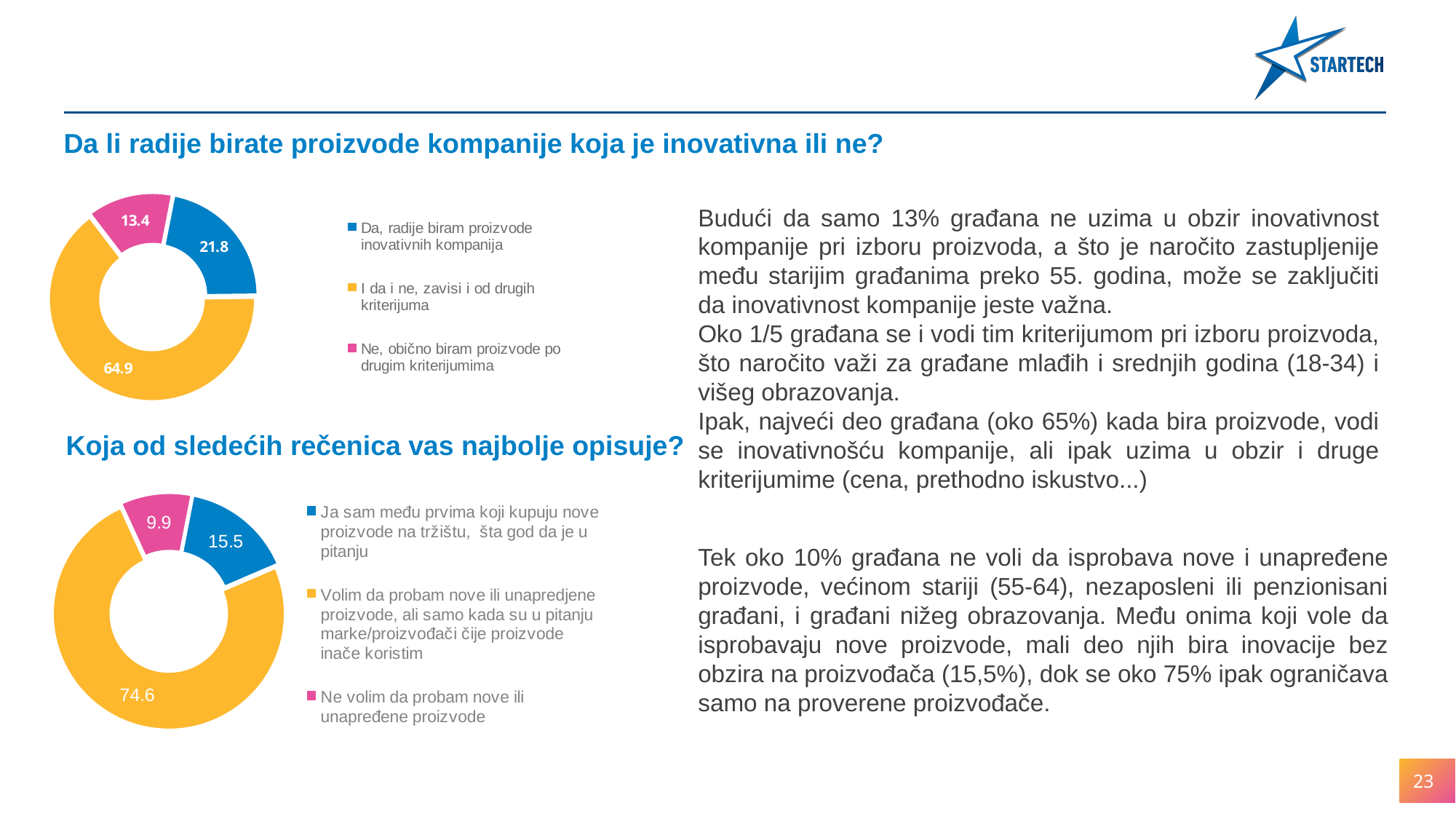
In the bottom chart 'Koja od sledećih rečenica vas najbolje opisuje?', what is the value for 'Volim da probam nove ili unapredjene proizvode, ali samo kada su u pitanju marke/proizvođači čije proizvode inače koristim'? 74.6 How many categories does the bottom chart 'Koja od sledećih rečenica vas najbolje opisuje?' show? 3 In the top chart 'Da li radije birate proizvode kompanije koja je inovativna ili ne?', what is the difference between the 'Da' slice and the 'Ne' slice? 8.4 In the top chart 'Da li radije birate proizvode kompanije koja je inovativna ili ne?', which category has the smallest share? Ne, obično biram proizvode po drugim kriterijumima In the bottom chart 'Koja od sledećih rečenica vas najbolje opisuje?', what is the value for 'Ne volim da probam nove ili unapređene proizvode'? 9.9 In the top chart 'Da li radije birate proizvode kompanije koja je inovativna ili ne?', what is the value for 'Da, radije biram proizvode inovativnih kompanija'? 21.8 What type of chart is the top chart 'Da li radije birate proizvode kompanije koja je inovativna ili ne?'? Donut (pie) chart In the top chart 'Da li radije birate proizvode kompanije koja je inovativna ili ne?', which category has the largest share? I da i ne, zavisi i od drugih kriterijuma In the top chart 'Da li radije birate proizvode kompanije koja je inovativna ili ne?', what is the value for 'Ne, obično biram proizvode po drugim kriterijumima'? 13.4 In the bottom chart 'Koja od sledećih rečenica vas najbolje opisuje?', what is the value for 'Ja sam među prvima koji kupuju nove proizvode na tržištu, šta god da je u pitanju'? 15.5 In the bottom chart 'Koja od sledećih rečenica vas najbolje opisuje?', which is larger: the blue slice or the pink slice? The blue slice (15.5) In the top chart 'Da li radije birate proizvode kompanije koja je inovativna ili ne?', what is the value for 'I da i ne, zavisi i od drugih kriterijuma'? 64.9